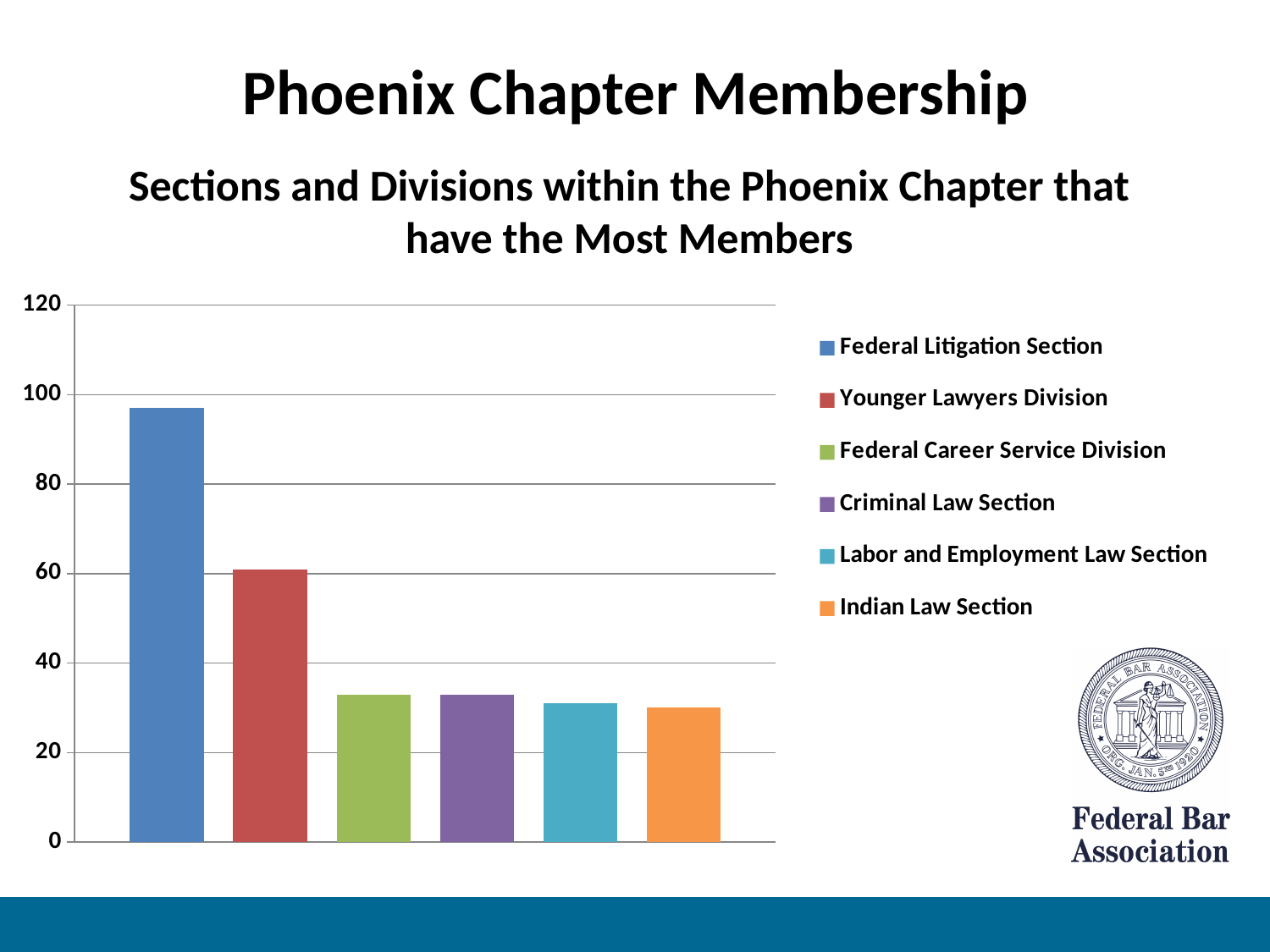
Which has more members, Federal Litigation Section or Younger Lawyers Division? Federal Litigation Section Is the value for Indian Law Section greater or less than 40? less What colour is the bar for Indian Law Section? orange How many entries does the legend list? 6 How many bars are plotted in the chart? 6 Which section or division has the highest number of members? Federal Litigation Section What kind of chart is shown on the slide? bar chart Is the value for Federal Litigation Section greater or less than 80? greater Do the bar values rise or fall from left to right across the chart? fall Is the value for Criminal Law Section greater or less than 20? greater